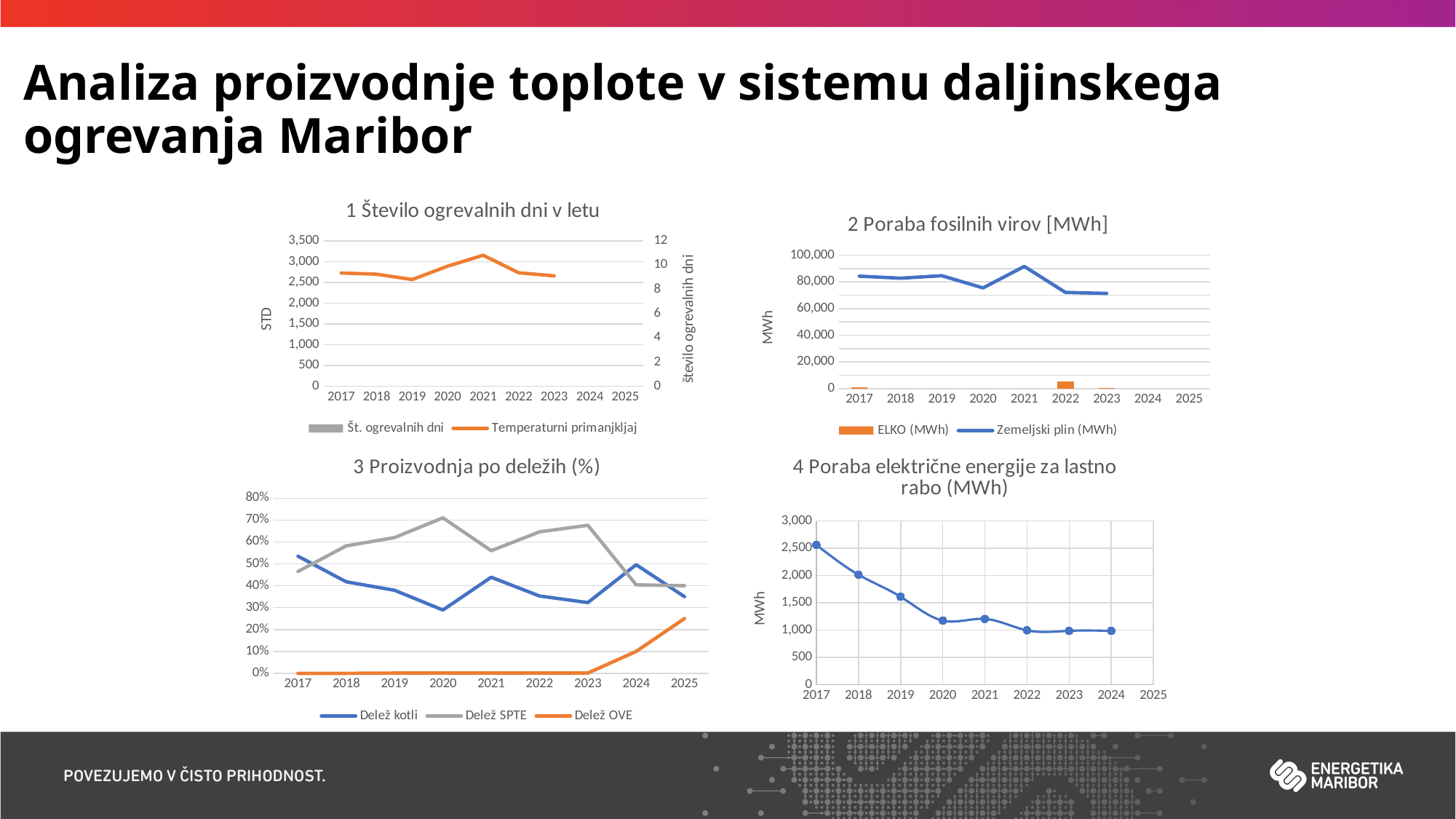
What kind of chart is "4 Poraba električne energije za lastno rabo (MWh)"? line chart In the chart "3 Proizvodnja po deležih (%)", how many series does the legend list? 3 In the chart "2 Poraba fosilnih virov [MWh]", is the Zemeljski plin (MWh) value for 2021 greater or less than 80,000? greater In the chart "3 Proizvodnja po deležih (%)", in which year is Delež SPTE highest? 2020 In the chart "2 Poraba fosilnih virov [MWh]", how many series does the legend list? 2 In the chart "1 Število ogrevalnih dni v letu", in which year is Temperaturni primanjkljaj highest? 2021 In the chart "3 Proizvodnja po deležih (%)", does Delež OVE rise or fall from 2023 to 2025? rise In the chart "2 Poraba fosilnih virov [MWh]", in which year is Zemeljski plin (MWh) highest? 2021 In the chart "4 Poraba električne energije za lastno rabo (MWh)", is the value for 2024 greater or less than 1,500? less In the chart "3 Proizvodnja po deležih (%)", which is larger in 2025: Delež kotli or Delež OVE? Delež kotli In the chart "4 Poraba električne energije za lastno rabo (MWh)", do the values rise or fall from 2017 to 2024? fall